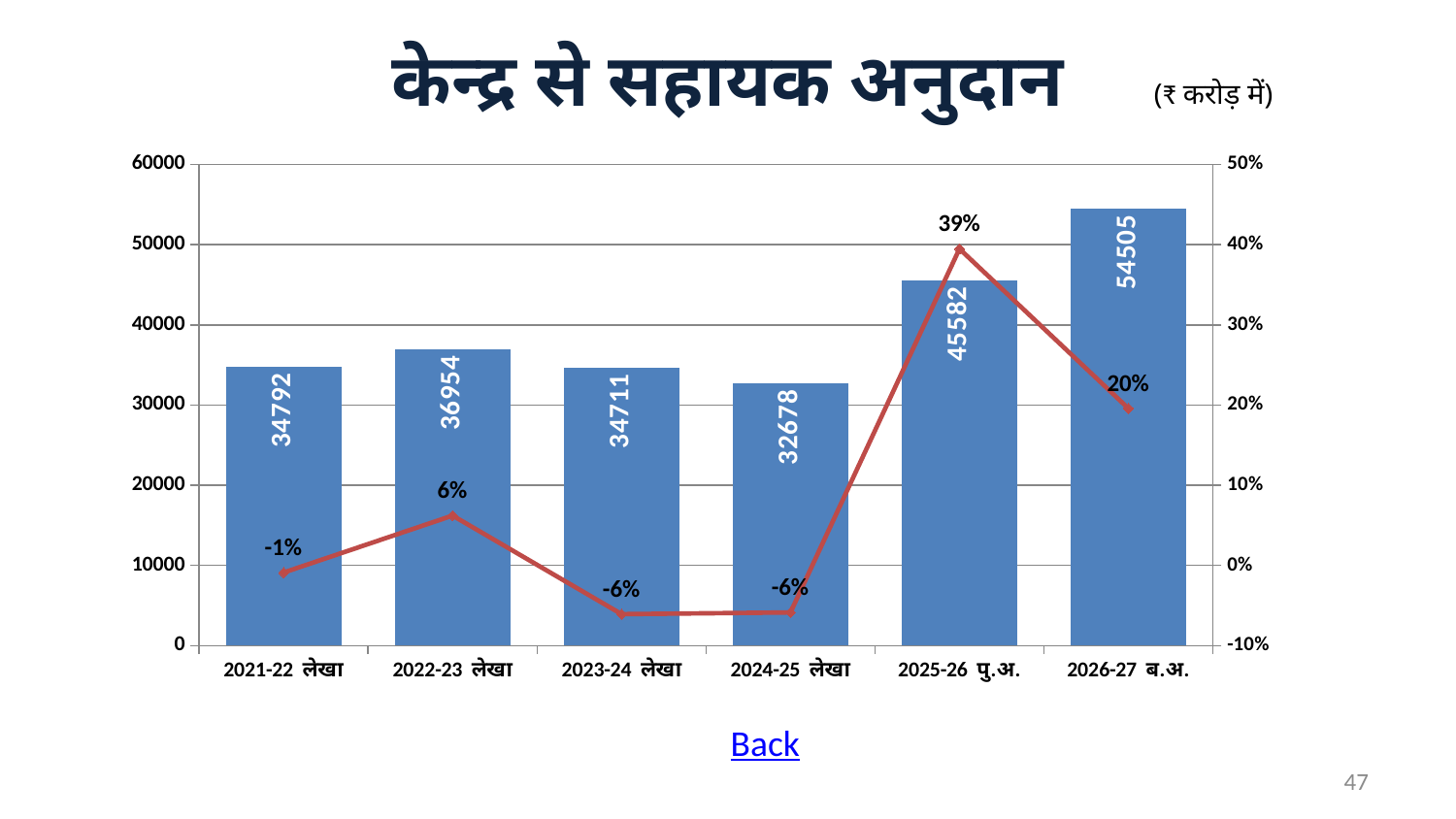
What kind of chart is this? Combined bar and line chart Which category has the highest bar value? 2026-27 ब.अ. What is the difference between the bar values for 2026-27 ब.अ. and 2025-26 पु.अ.? 8923 Which is larger, the bar value for 2022-23 लेखा or for 2023-24 लेखा? 2022-23 लेखा Do the bar values rise or fall from 2024-25 लेखा to 2026-27 ब.अ.? Rise What is the title of the chart? केन्द्र से सहायक अनुदान What is the bar value for 2024-25 लेखा? 32678 What growth percentage is shown on the line for 2025-26 पु.अ.? 39% What growth percentage is shown on the line for 2021-22 लेखा? -1% What is the bar value for 2026-27 ब.अ.? 54505 How many categories are shown on the x axis? 6 Which category has the lowest bar value? 2024-25 लेखा